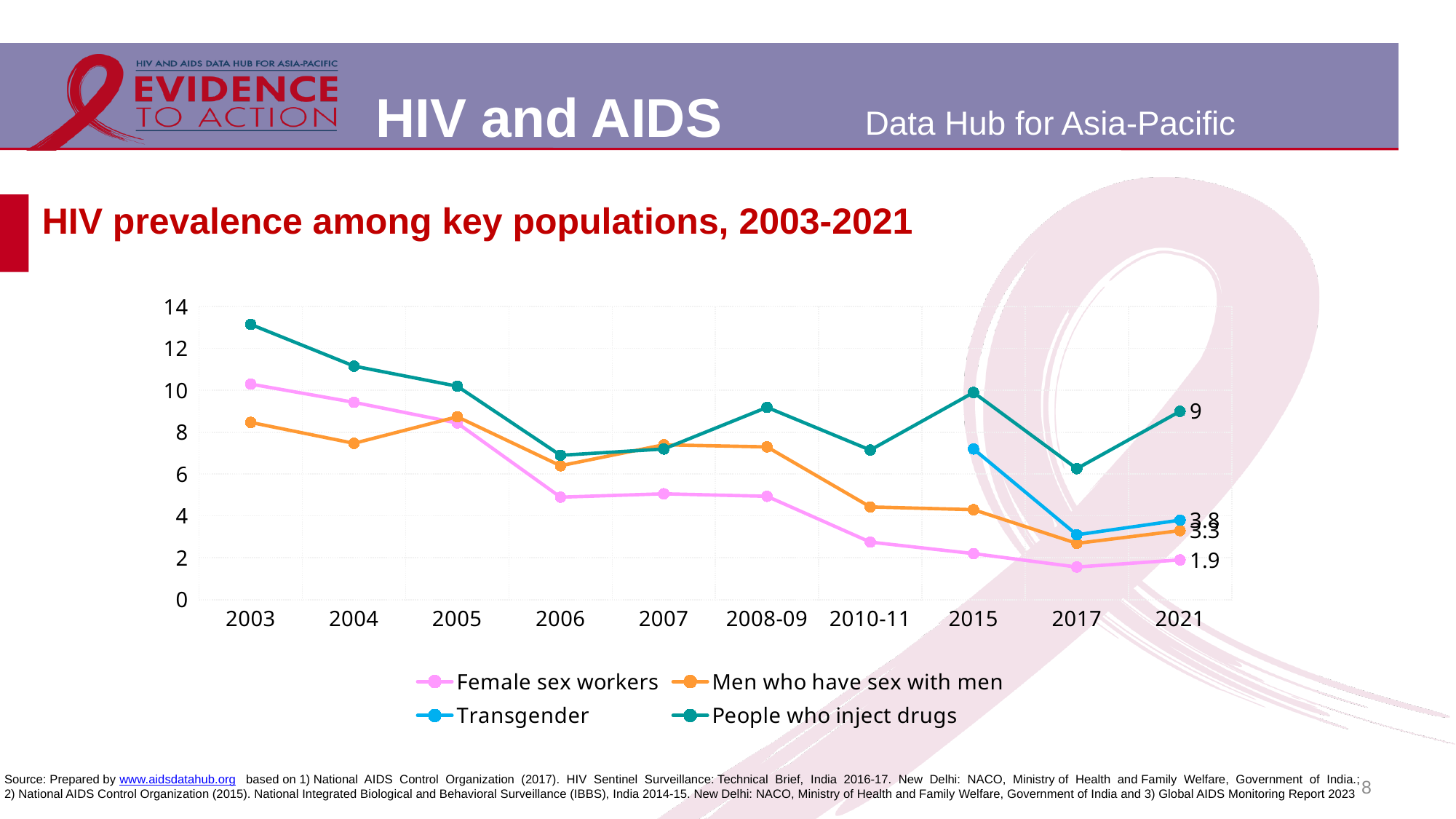
Is the value for female sex workers in 2017 greater or less than 2? less Which key population had the highest HIV prevalence in 2003? People who inject drugs What is the HIV prevalence among female sex workers in 2021? 1.9 What is the difference between the 2021 values for people who inject drugs and female sex workers? 7.1 What is the HIV prevalence among people who inject drugs in 2021? 9 How many series does the legend list? 4 Does HIV prevalence among female sex workers rise or fall from 2003 to 2021? fall How many time points are shown on the x axis? 10 What is the title of the chart? HIV prevalence among key populations, 2003-2021 In 2021, which is larger: the value for people who inject drugs or the value for female sex workers? People who inject drugs Is the value for people who inject drugs in 2003 greater or less than 12? greater What kind of chart is shown on the slide? line chart